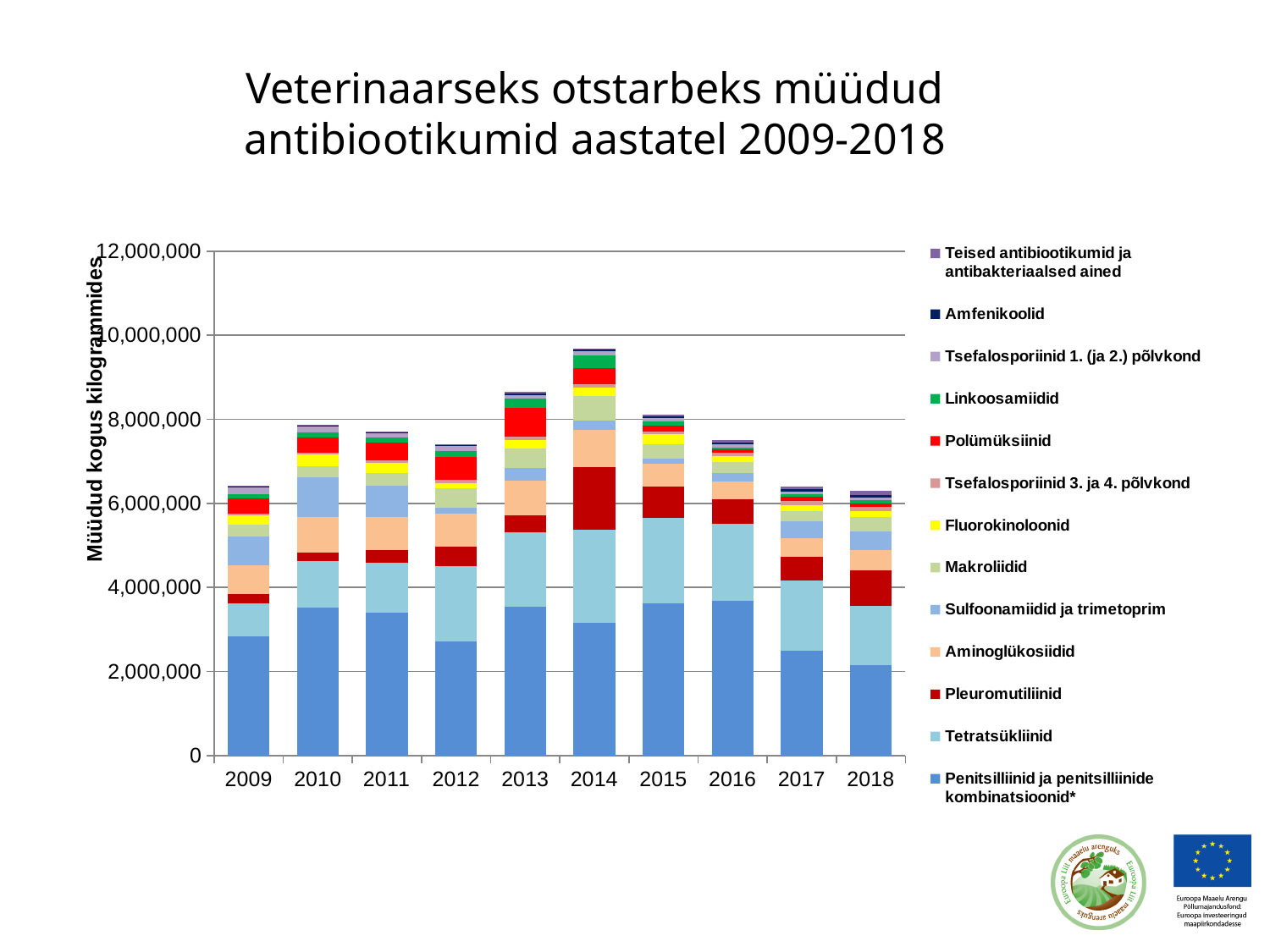
What is the title of the chart's vertical axis? Müüdud kogus kilogrammides What kind of chart is shown on the slide? stacked bar chart Which year has the larger total, 2014 or 2009? 2014 How many years are shown on the x axis of the chart? 10 Is the total for 2009 greater or less than 8,000,000? less Is the total for 2014 greater or less than 8,000,000? greater Which year has the highest total stacked bar? 2014 Do the total values rise or fall from 2014 to 2018? fall Is the total for 2013 greater or less than 8,000,000? greater How many series does the chart's legend list? 13